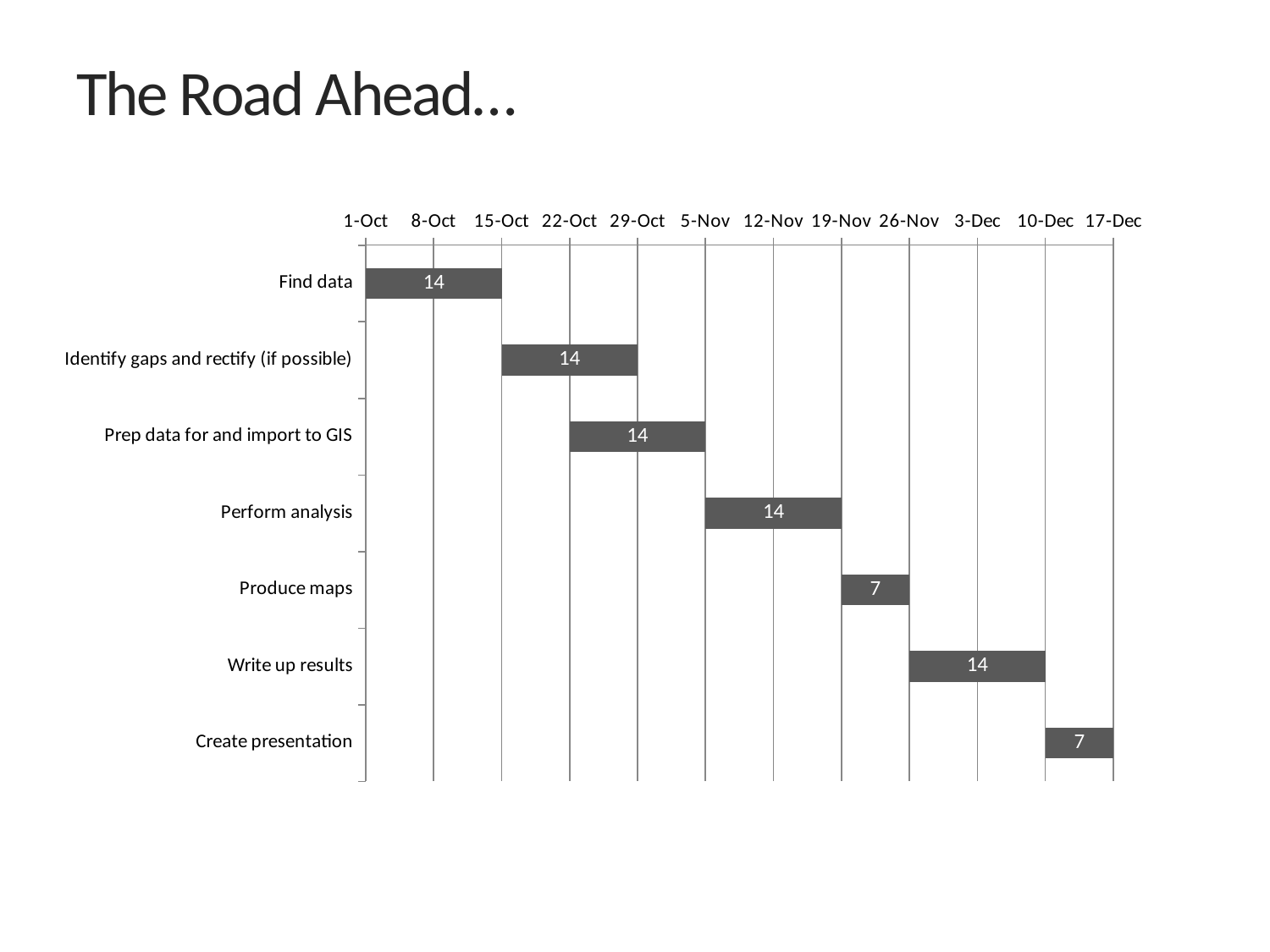
What is the value shown on the bar for Produce maps? 7 What kind of chart is shown on the slide? bar chart What is the value shown on the bar for Find data? 14 What is the title of the slide containing the chart? The Road Ahead… What is the value shown on the bar for Create presentation? 7 How many tasks (categories) are listed on the vertical axis of the chart? 7 At which date on the horizontal axis does the Find data bar begin? 1-Oct What is the difference between the value for Perform analysis and the value for Produce maps? 7 At which date on the horizontal axis does the Perform analysis bar begin? 5-Nov What is the value shown on the bar for Write up results? 14 At which date on the horizontal axis does the Create presentation bar end? 17-Dec Which has the larger value, Write up results or Create presentation? Write up results